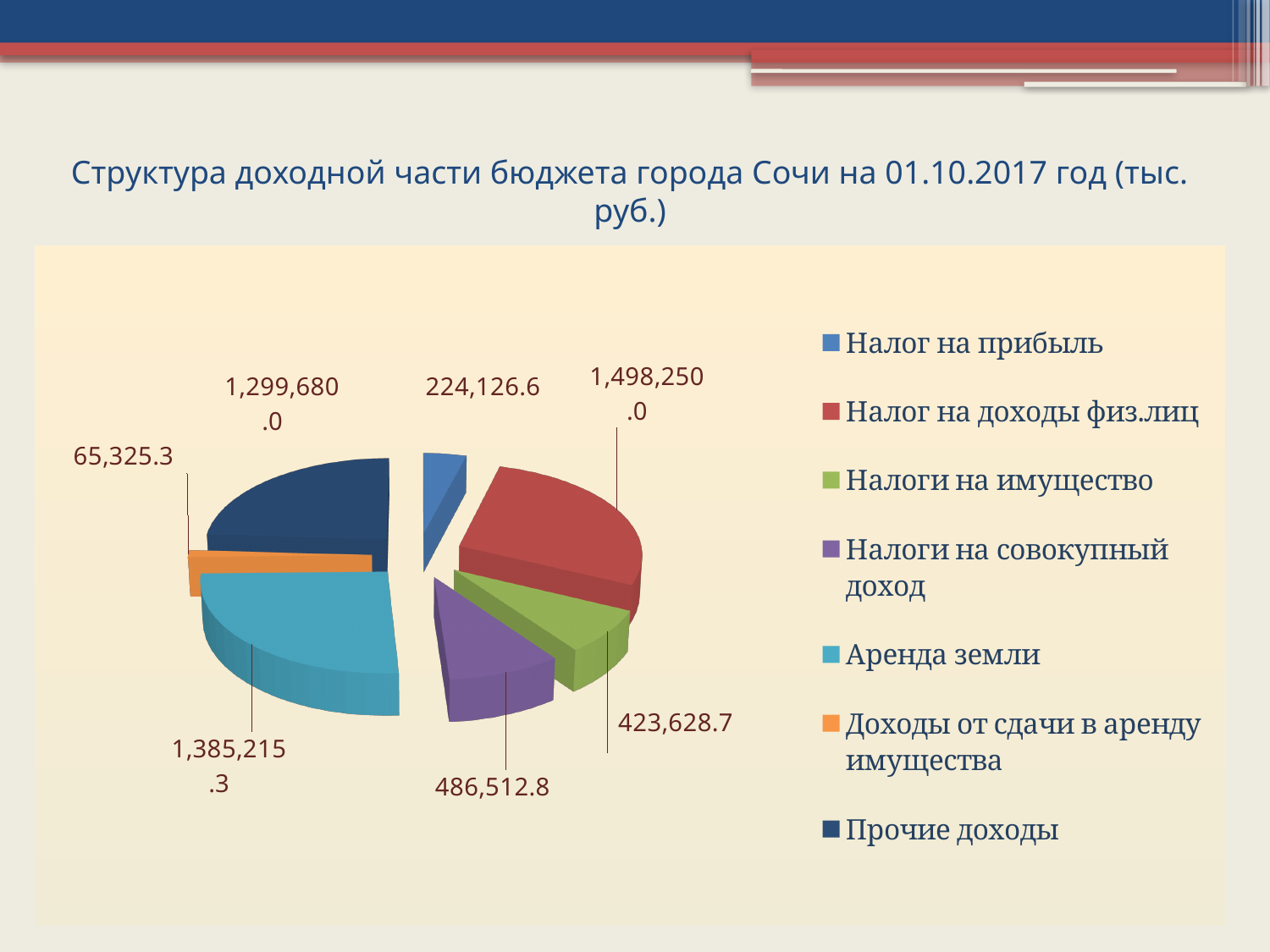
Which category has the largest value? Налог на доходы физ.лиц What is the difference between Налоги на совокупный доход and Налоги на имущество? 62,884.1 What is the value for Налог на доходы физ.лиц? 1,498,250.0 What kind of chart is shown on the slide? Pie chart What is the value for Доходы от сдачи в аренду имущества? 65,325.3 What is the difference between Налог на доходы физ.лиц and Аренда земли? 113,034.7 What colour is the slice for Прочие доходы? Dark blue Which category has the smallest value? Доходы от сдачи в аренду имущества How many categories does the pie chart show? 7 Which is larger: Налоги на имущество or Налоги на совокупный доход? Налоги на совокупный доход What is the value for Налоги на совокупный доход? 486,512.8 What is the value for Аренда земли? 1,385,215.3